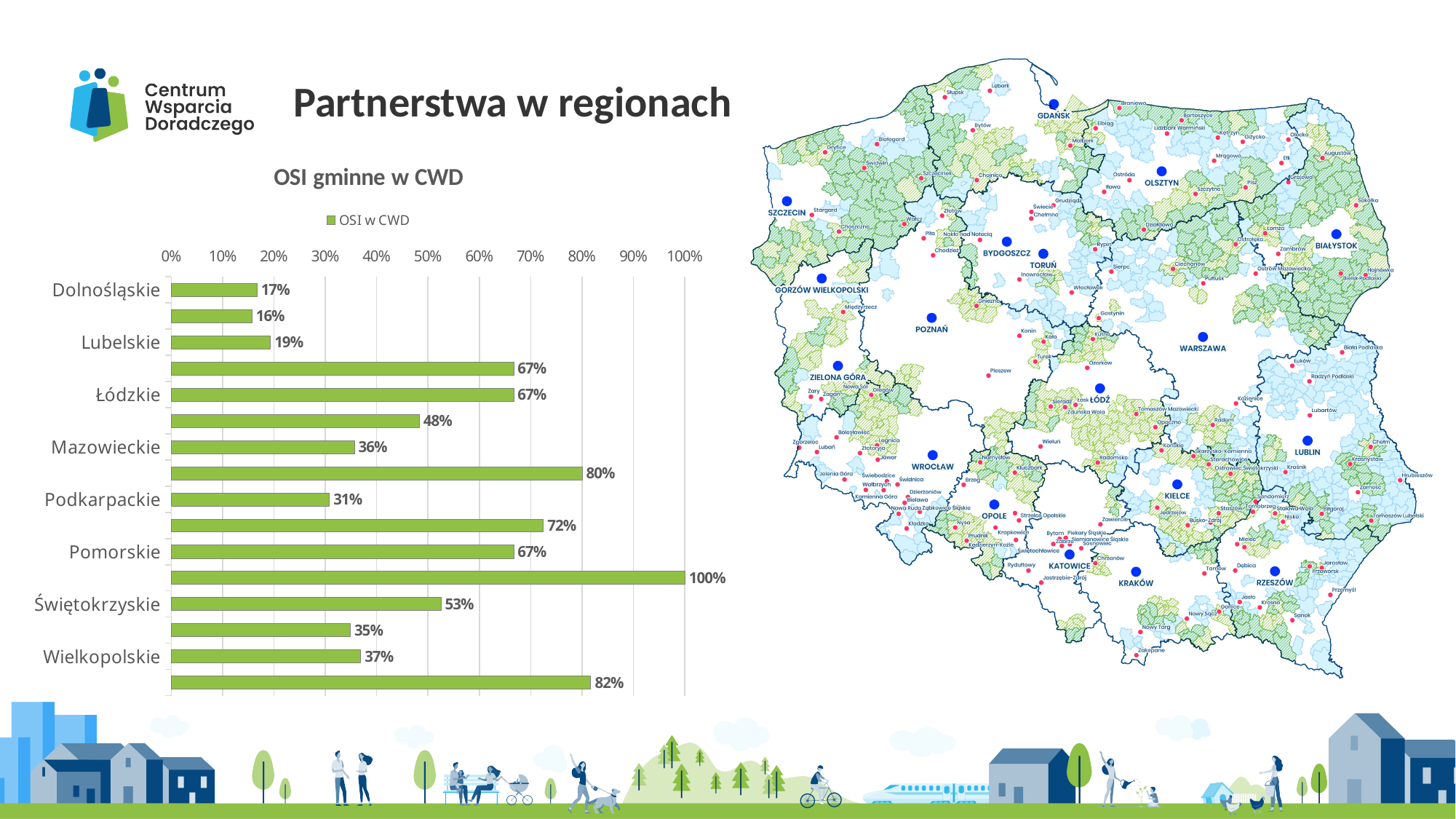
What is the value for Mazowieckie? 36% What is the value for Lubelskie? 19% What type of chart is shown on the slide? bar chart How many series does the chart legend list? 1 What is the value for Świętokrzyskie? 53% What is the title of the chart? OSI gminne w CWD Which has a larger value, Łódzkie or Podkarpackie? Łódzkie What is the highest value shown in the chart? 100% How many bars are plotted in the chart? 16 What is the lowest value shown in the chart? 16% What is the difference between the values for Świętokrzyskie and Mazowieckie? 17 percentage points What is the value for Dolnośląskie? 17%